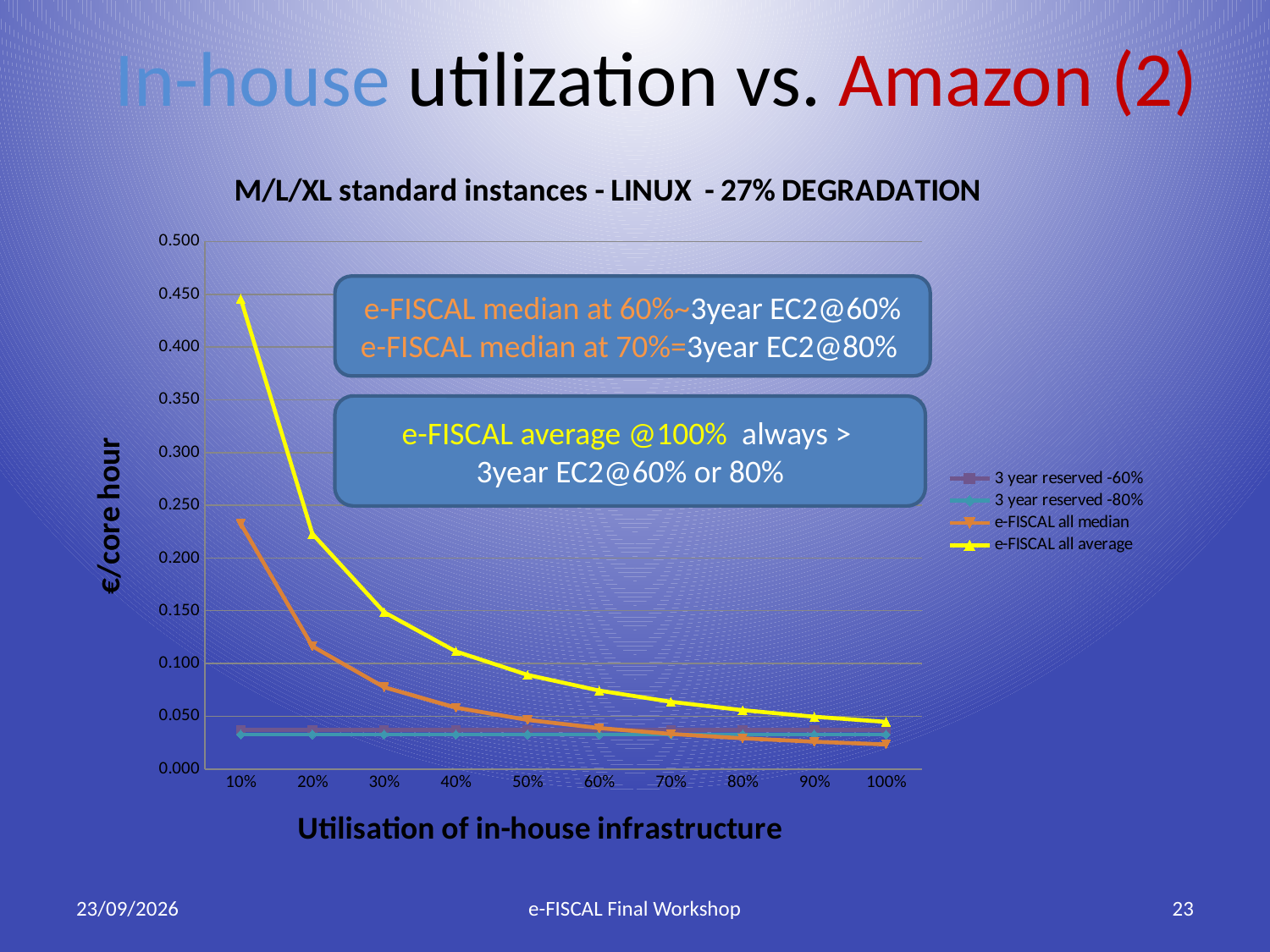
At which utilisation level is the e-FISCAL all average value highest? 10% At 20% utilisation, which series has the larger value: e-FISCAL all average or e-FISCAL all median? e-FISCAL all average Does the e-FISCAL all average series rise or fall as utilisation increases from 10% to 100%? fall What kind of chart is shown on the slide? line chart Is the e-FISCAL all median value at 30% utilisation greater or less than 0.100? less What is the label of the vertical axis? €/core hour How many utilisation categories are shown on the x axis? 10 How many series does the chart legend list? 4 What is the title of the chart? M/L/XL standard instances - LINUX - 27% DEGRADATION Is the e-FISCAL all average value at 10% utilisation greater or less than 0.400? greater Is the e-FISCAL all median value at 10% utilisation greater or less than 0.200? greater